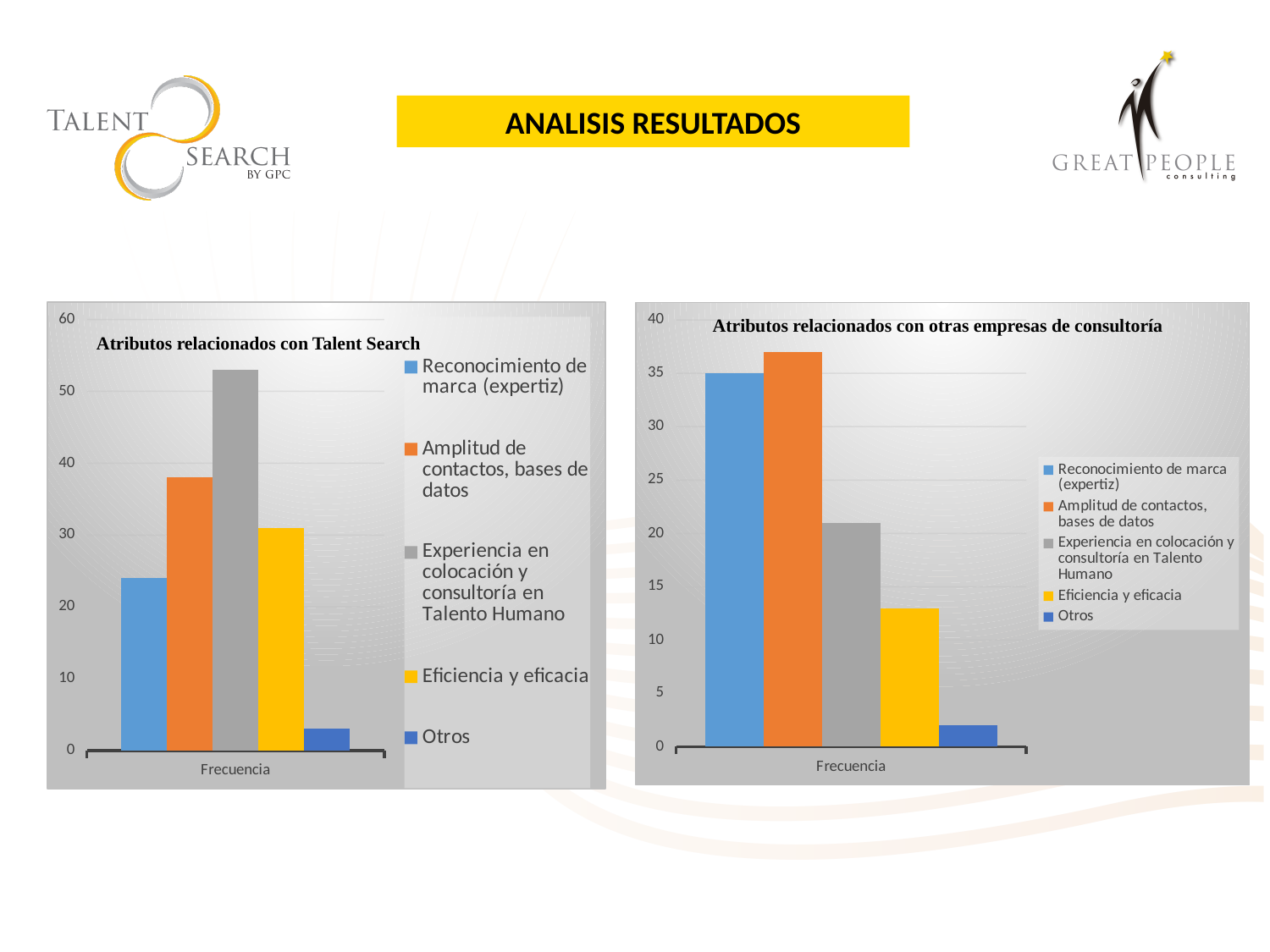
In the chart 'Atributos relacionados con Talent Search', which series has the lowest value? Otros In the chart 'Atributos relacionados con Talent Search', is the value for 'Amplitud de contactos, bases de datos' greater or less than 30? greater How many series does the legend list in the chart 'Atributos relacionados con Talent Search'? 5 In the chart 'Atributos relacionados con Talent Search', which is larger: 'Eficiencia y eficacia' or 'Reconocimiento de marca (expertiz)'? Eficiencia y eficacia In the chart 'Atributos relacionados con otras empresas de consultoría', which is larger: 'Experiencia en colocación y consultoría en Talento Humano' or 'Eficiencia y eficacia'? Experiencia en colocación y consultoría en Talento Humano What kind of chart is 'Atributos relacionados con Talent Search'? bar chart In the chart 'Atributos relacionados con otras empresas de consultoría', which series has the lowest value? Otros In the chart 'Atributos relacionados con otras empresas de consultoría', is the value for 'Experiencia en colocación y consultoría en Talento Humano' greater or less than 25? less How many series does the legend list in the chart 'Atributos relacionados con otras empresas de consultoría'? 5 In the chart 'Atributos relacionados con Talent Search', is the value for 'Reconocimiento de marca (expertiz)' greater or less than 30? less In the chart 'Atributos relacionados con otras empresas de consultoría', which series has the highest value? Amplitud de contactos, bases de datos In the chart 'Atributos relacionados con Talent Search', which series has the highest value? Experiencia en colocación y consultoría en Talento Humano